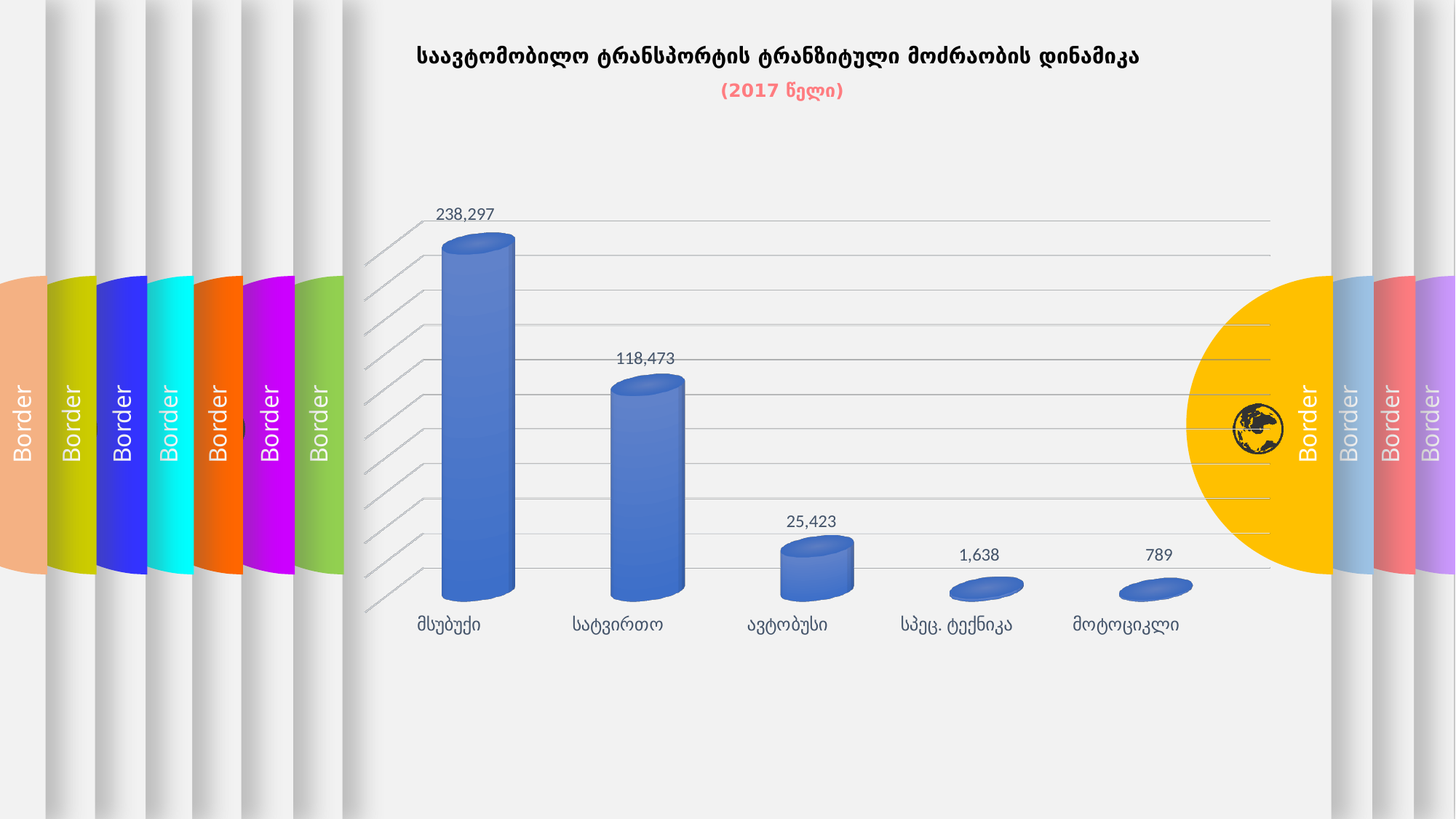
What is the value for სატვირთო? 118,473 What is the value for ავტობუსი? 25,423 Which is larger, the value for ავტობუსი or the value for სპეც. ტექნიკა? ავტობუსი What kind of chart is shown on the slide? Bar chart Which category has the highest value? მსუბუქი What is the difference between the values for მსუბუქი and სატვირთო? 119,824 What is the value for მსუბუქი? 238,297 What is the value for მოტოციკლი? 789 What is the value for სპეც. ტექნიკა? 1,638 Which category has the lowest value? მოტოციკლი Which year is shown in the chart's subtitle? 2017 How many categories are shown on the chart? 5